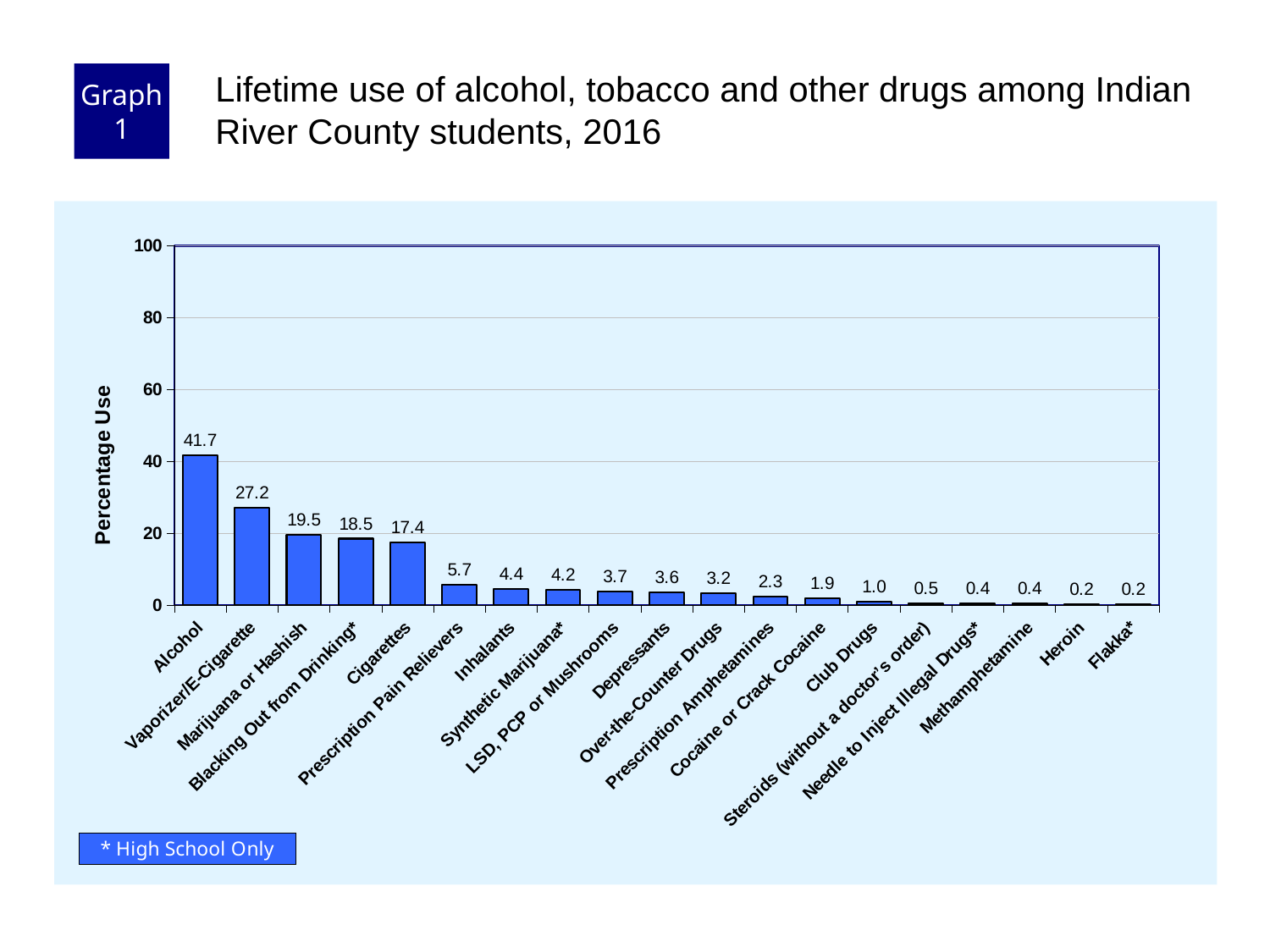
What is the percentage use for Alcohol? 41.7 Which category has the highest percentage use? Alcohol What is the percentage use for Cigarettes? 17.4 Which has a higher percentage use, Inhalants or Depressants? Inhalants Is the value for Alcohol greater or less than 40? greater What is the percentage use for Club Drugs? 1.0 What is the percentage use for Prescription Pain Relievers? 5.7 What is the difference in percentage use between Marijuana or Hashish and Blacking Out from Drinking*? 1.0 What kind of chart is shown on the slide? Bar chart How many categories are shown on the x axis? 19 What is the difference in percentage use between Alcohol and Vaporizer/E-Cigarette? 14.5 What is the percentage use for Vaporizer/E-Cigarette? 27.2